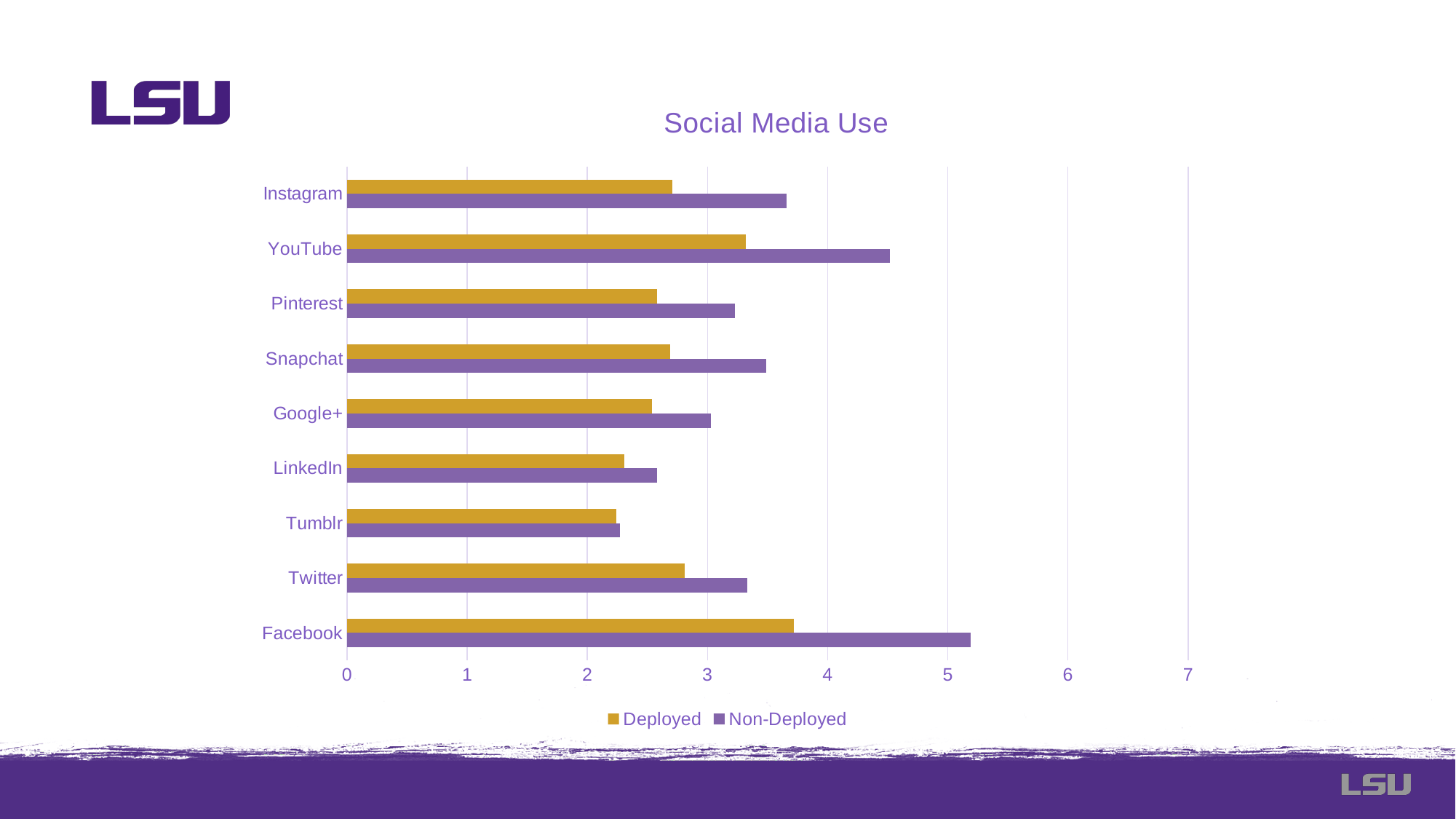
Which is larger: the Deployed value for Twitter or the Deployed value for Tumblr? Twitter Is the Deployed value for Instagram greater or less than 3? less How many social media platforms are shown on the chart? 9 How many series does the legend list? 2 What is the title of the chart? Social Media Use Which is larger: the Non-Deployed value for Facebook or the Non-Deployed value for YouTube? Facebook Is the Non-Deployed value for YouTube greater or less than 4? greater Which platform has the highest Non-Deployed value? Facebook Is the Non-Deployed value for Facebook greater or less than 5? greater Which platform has the highest Deployed value? Facebook What kind of chart is shown on the slide? bar chart Which platform has the lowest Non-Deployed value? Tumblr